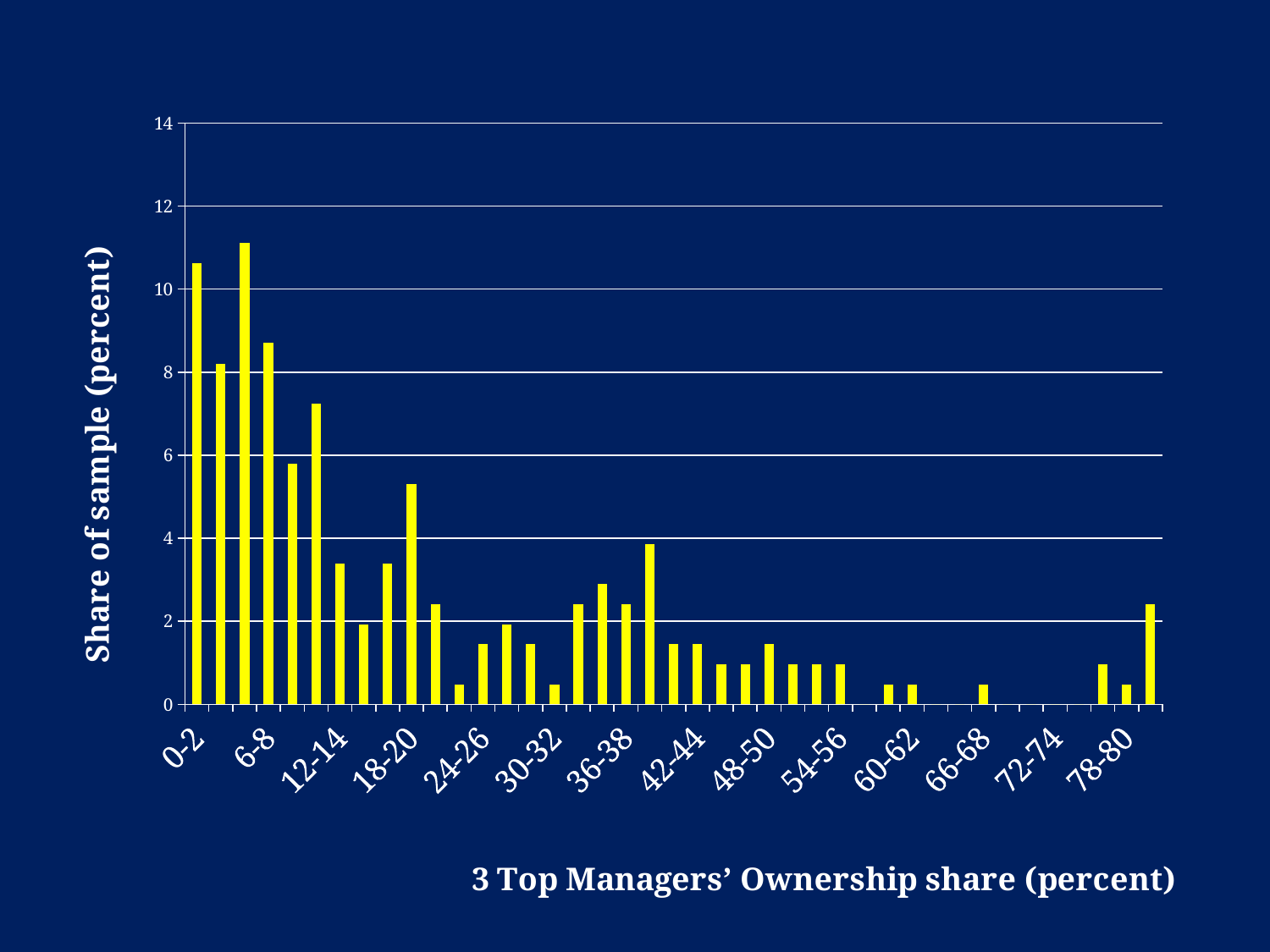
Is the value for the 12-14 category greater or less than 4? less Is the value for the 36-38 category greater or less than 4? less Do the values generally rise or fall as the ownership share increases along the x axis? fall Is the value for the 0-2 category greater or less than 10? greater Which has the larger value, the 18-20 category or the 12-14 category? 18-20 What kind of chart is shown on the slide? bar chart What is the title of the horizontal axis? 3 Top Managers' Ownership share (percent) What is the title of the vertical axis? Share of sample (percent) Which has the larger value, the 0-2 category or the 6-8 category? 0-2